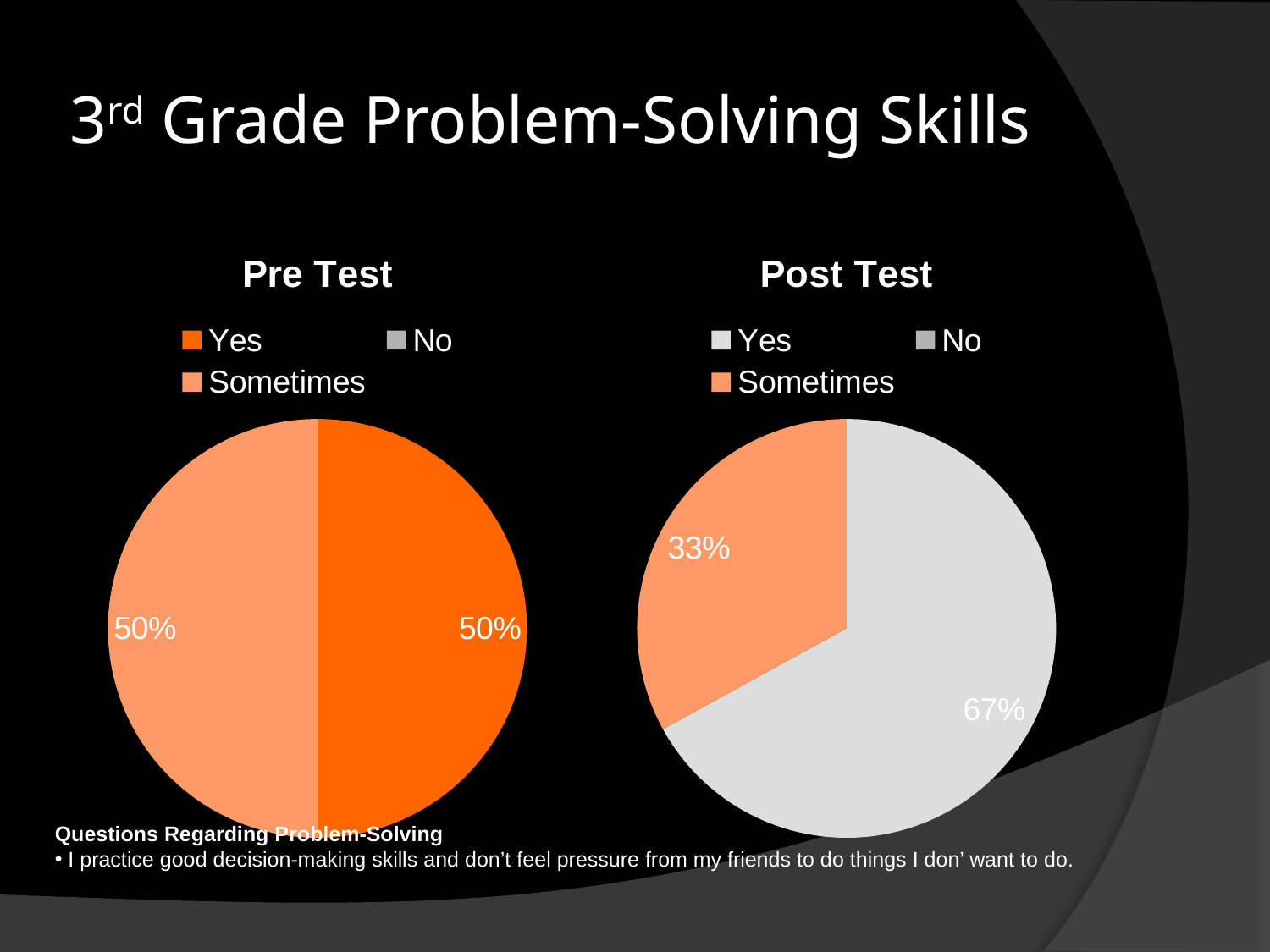
What kind of chart is the Pre Test chart? Pie chart In the Post Test chart, what colour is the Sometimes slice? Orange In the Post Test chart, what is the difference between the Yes and Sometimes percentages? 34% In the Post Test chart, which category has the largest slice? Yes In the Post Test chart, what percentage is shown for Sometimes? 33% How many slices are visible in the Pre Test pie chart? 2 In the Pre Test chart, what percentage is shown for Sometimes? 50% How many entries does the legend of the Post Test chart list? 3 What is the title of the chart on the left? Pre Test In the Post Test chart, which is larger, Yes or Sometimes? Yes In the Post Test chart, what percentage is shown for Yes? 67% In the Pre Test chart, what percentage is shown for Yes? 50%